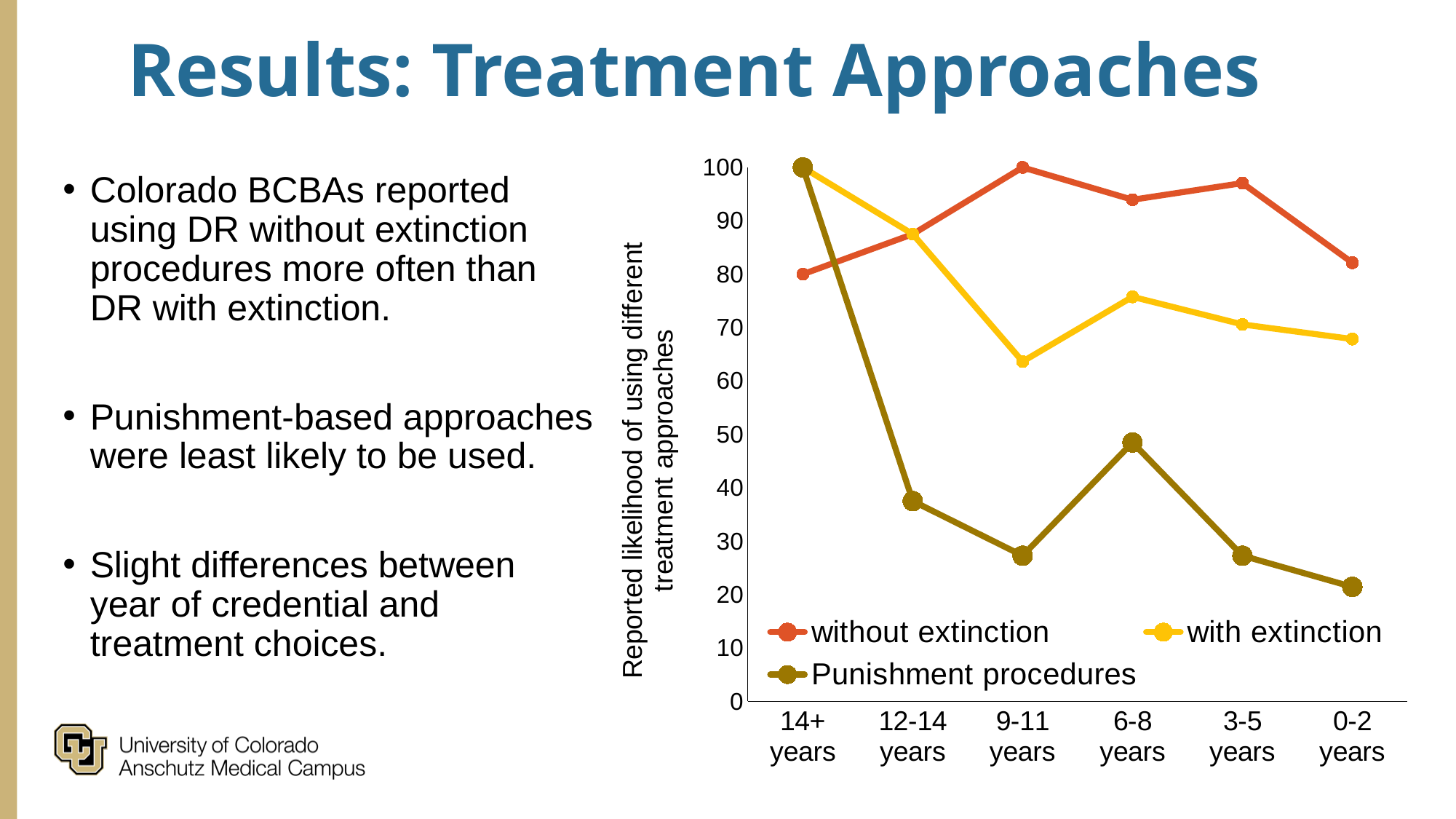
At which year-of-credential category is the without extinction line highest? 9-11 years What is the value for without extinction at 9-11 years? 100 How many series does the chart legend list? 3 What is the value for without extinction at 14+ years? 80 What kind of chart is shown on the slide? line chart What is the value for Punishment procedures at 14+ years? 100 Is the value for Punishment procedures at 12-14 years greater or less than 40? less At which year-of-credential category is the Punishment procedures line lowest? 0-2 years How many year-of-credential categories are shown on the x axis? 6 What is the label of the y axis? Reported likelihood of using different treatment approaches Is the value for with extinction at 9-11 years greater or less than 60? greater At 6-8 years, which is larger: without extinction or with extinction? without extinction